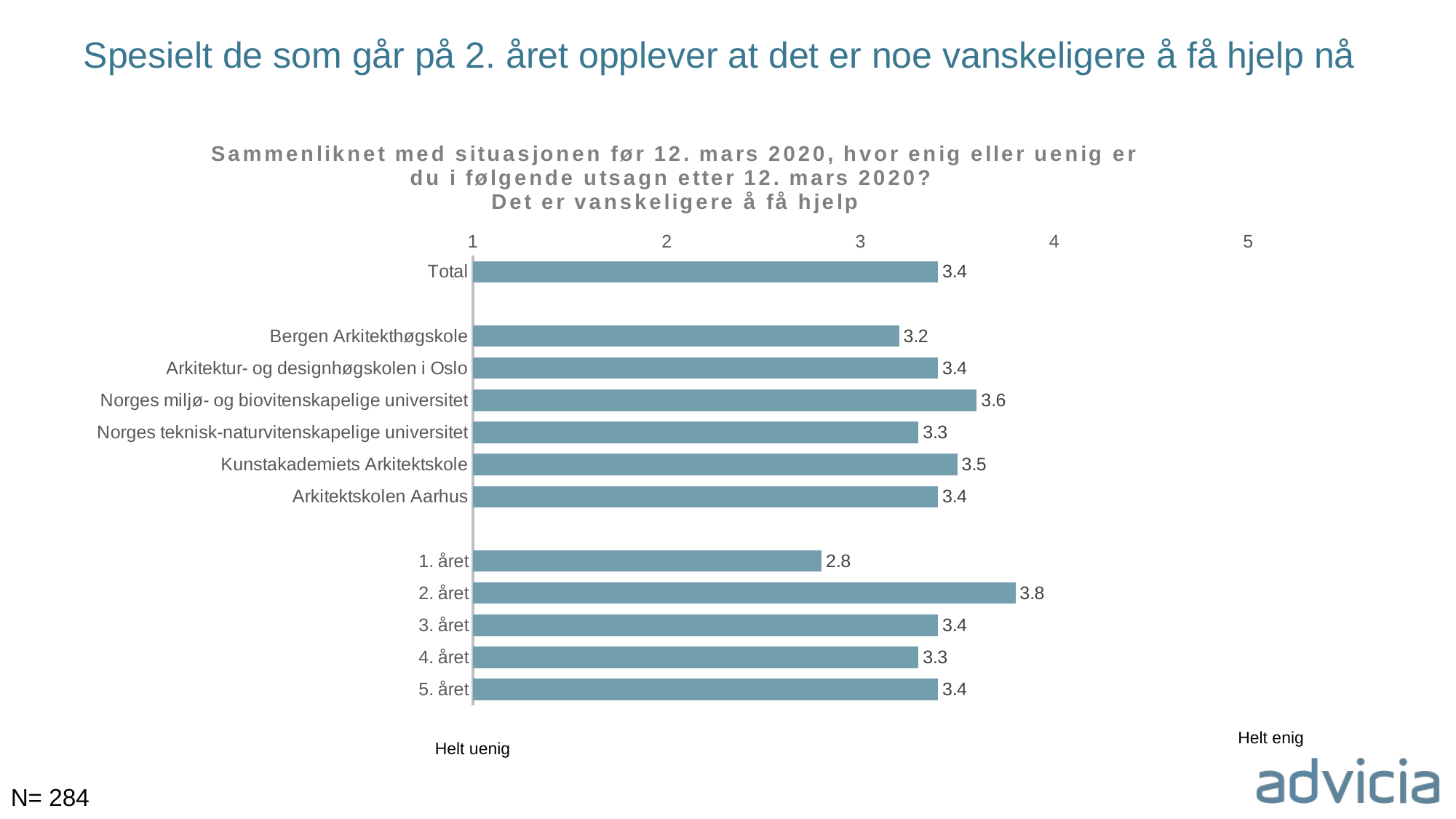
Which is larger, the value for Kunstakademiets Arkitektskole or the value for Norges teknisk-naturvitenskapelige universitet? Kunstakademiets Arkitektskole What is the value for Norges miljø- og biovitenskapelige universitet? 3.6 Which category has the highest value? 2. året What label appears at the left end of the scale below the chart? Helt uenig How many bars are plotted in the chart? 12 What is the value for Bergen Arkitekthøgskole? 3.2 What is the value for Total? 3.4 What is the value for 2. året? 3.8 What kind of chart is shown on the slide? bar chart What is the difference between the values for 2. året and 1. året? 1.0 Is the value for 1. året greater or less than 3? less Which category has the lowest value? 1. året